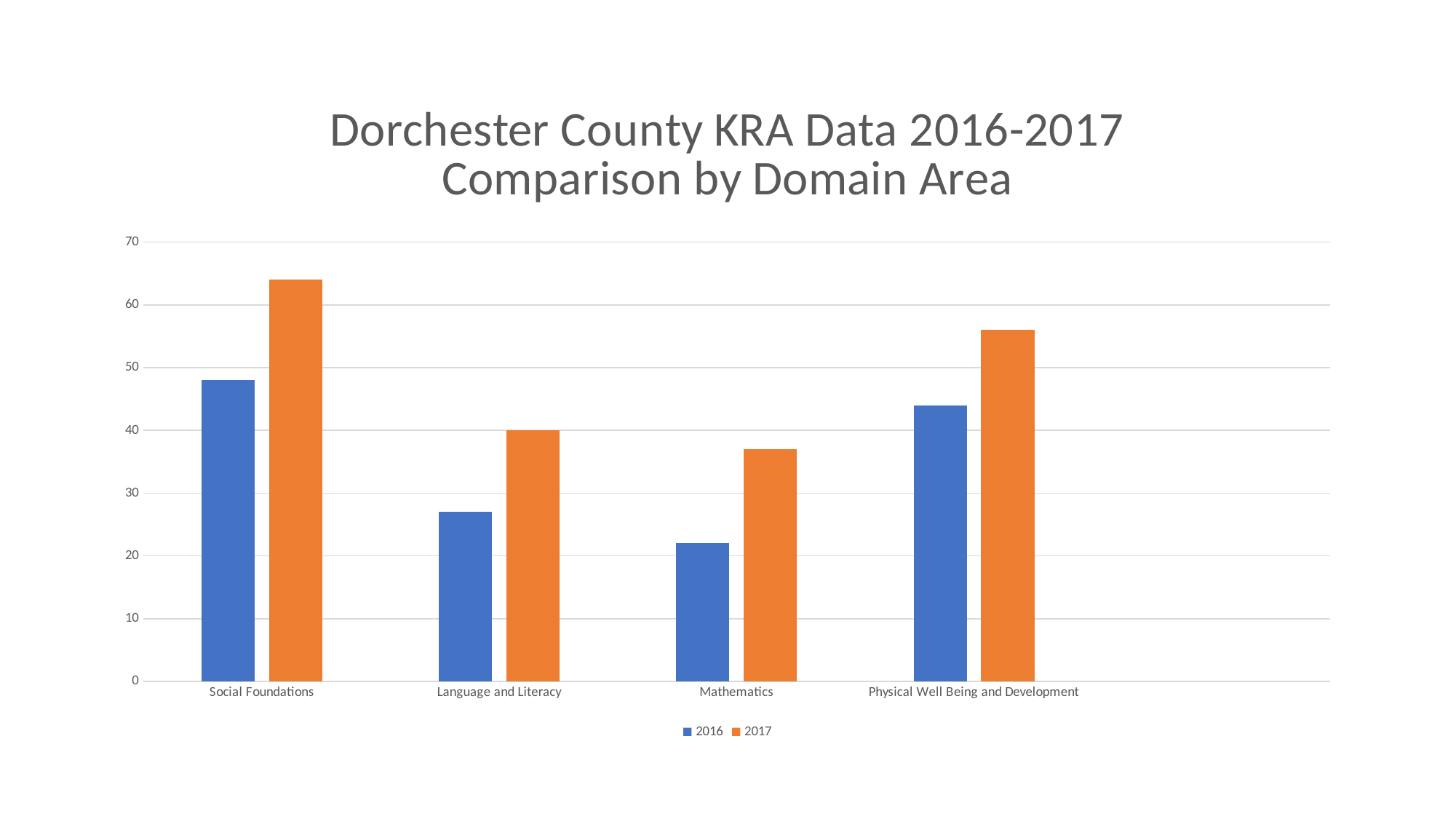
Which domain area has the lowest 2016 value? Mathematics For Language and Literacy, which is larger, the 2016 value or the 2017 value? 2017 How many domain areas are shown on the x axis? 4 Is the 2017 value for Social Foundations greater or less than 60? greater Is the 2016 value for Mathematics greater or less than 30? less What is the title of the chart? Dorchester County KRA Data 2016-2017 Comparison by Domain Area How many series does the legend list? 2 Which domain area has the lowest 2017 value? Mathematics Is the 2016 value for Physical Well Being and Development greater or less than 40? greater Which domain area has the highest 2017 value? Social Foundations Which is larger, the 2016 value for Social Foundations or the 2016 value for Physical Well Being and Development? Social Foundations What kind of chart is shown on the slide? bar chart